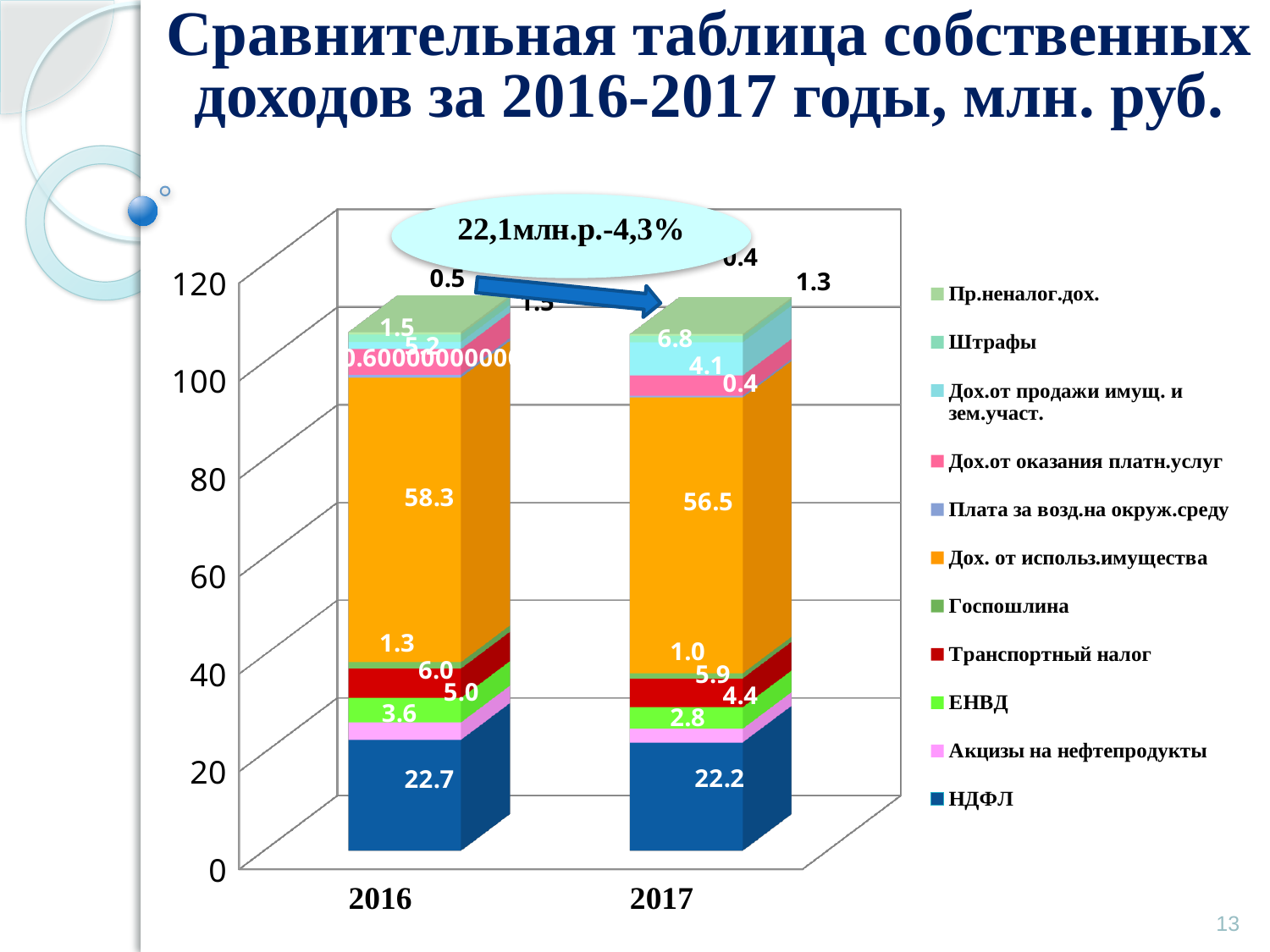
What text is written in the callout above the bars? 22,1млн.р.-4,3% Does the value of Акцизы на нефтепродукты rise or fall from 2016 to 2017? Fall How many years (categories) are plotted on the x axis? 2 Which year has the larger value for ЕНВД, 2016 or 2017? 2016 What type of chart is shown on the slide? Stacked bar chart What is the value of НДФЛ for 2016? 22.7 By how much did Дох. от использ.имущества decrease from 2016 (58.3) to 2017 (56.5)? 1.8 What is the value of НДФЛ for 2017? 22.2 Which series has the largest segment in the 2016 bar? Дох. от использ.имущества What is the value of Транспортный налог for 2016? 6.0 How many series does the legend list? 11 What is the value of Дох. от использ.имущества for 2017? 56.5